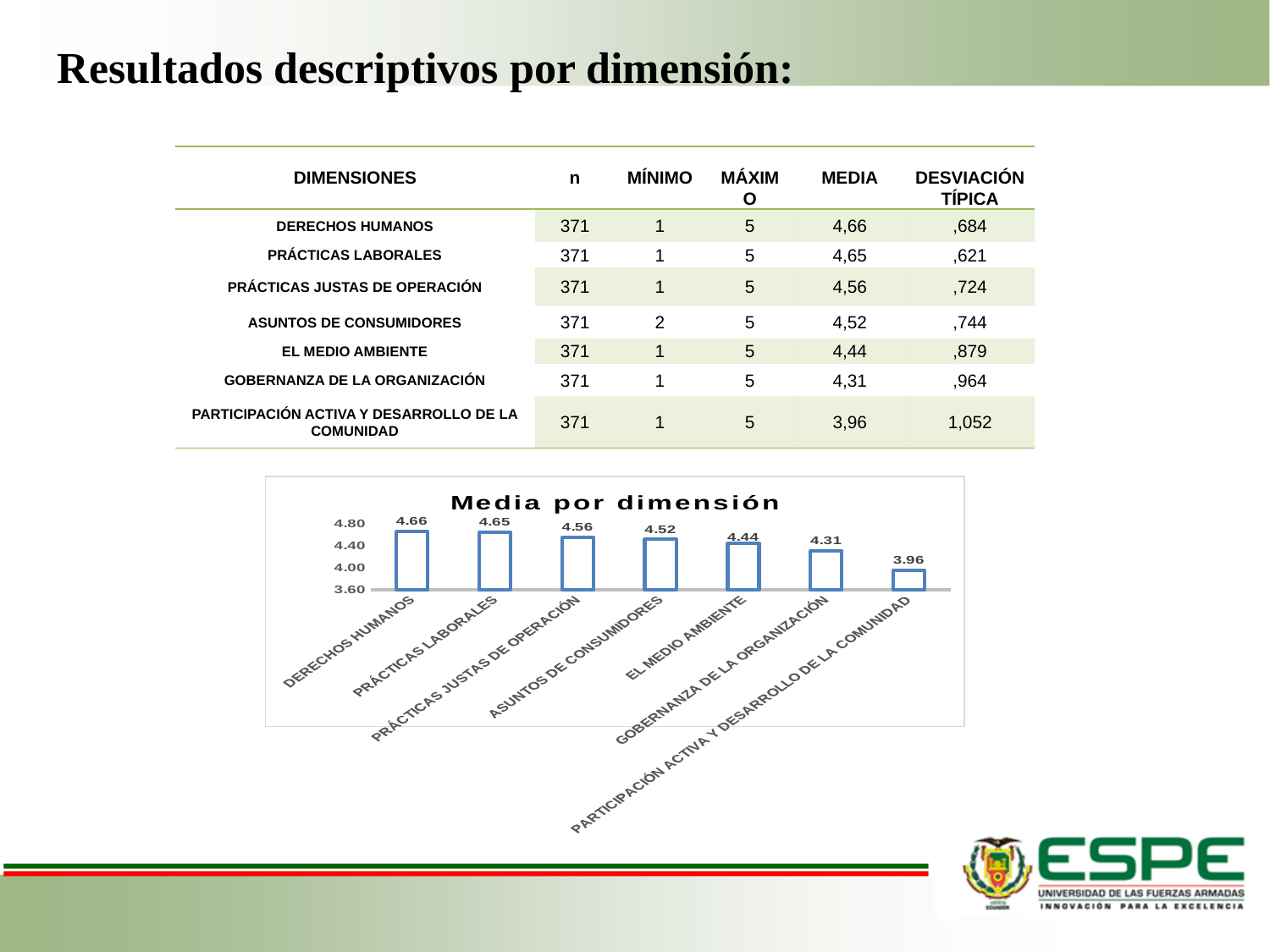
Which category has the lowest value in the 'Media por dimensión' chart? PARTICIPACIÓN ACTIVA Y DESARROLLO DE LA COMUNIDAD How many categories are shown in the 'Media por dimensión' chart? 7 In the 'Media por dimensión' chart, which is larger: the value for EL MEDIO AMBIENTE or the value for GOBERNANZA DE LA ORGANIZACIÓN? EL MEDIO AMBIENTE In the 'Media por dimensión' chart, is the value for PARTICIPACIÓN ACTIVA Y DESARROLLO DE LA COMUNIDAD greater or less than 4.00? less Do the values in the 'Media por dimensión' chart rise or fall from left to right? fall What is the value for DERECHOS HUMANOS in the 'Media por dimensión' chart? 4.66 In the 'Media por dimensión' chart, what is the difference between the values for PRÁCTICAS JUSTAS DE OPERACIÓN and ASUNTOS DE CONSUMIDORES? 0.04 In the 'Media por dimensión' chart, what is the difference between the values for DERECHOS HUMANOS and PARTICIPACIÓN ACTIVA Y DESARROLLO DE LA COMUNIDAD? 0.70 What is the value for EL MEDIO AMBIENTE in the 'Media por dimensión' chart? 4.44 Which category has the highest value in the 'Media por dimensión' chart? DERECHOS HUMANOS What kind of chart is 'Media por dimensión'? bar chart What is the value for GOBERNANZA DE LA ORGANIZACIÓN in the 'Media por dimensión' chart? 4.31